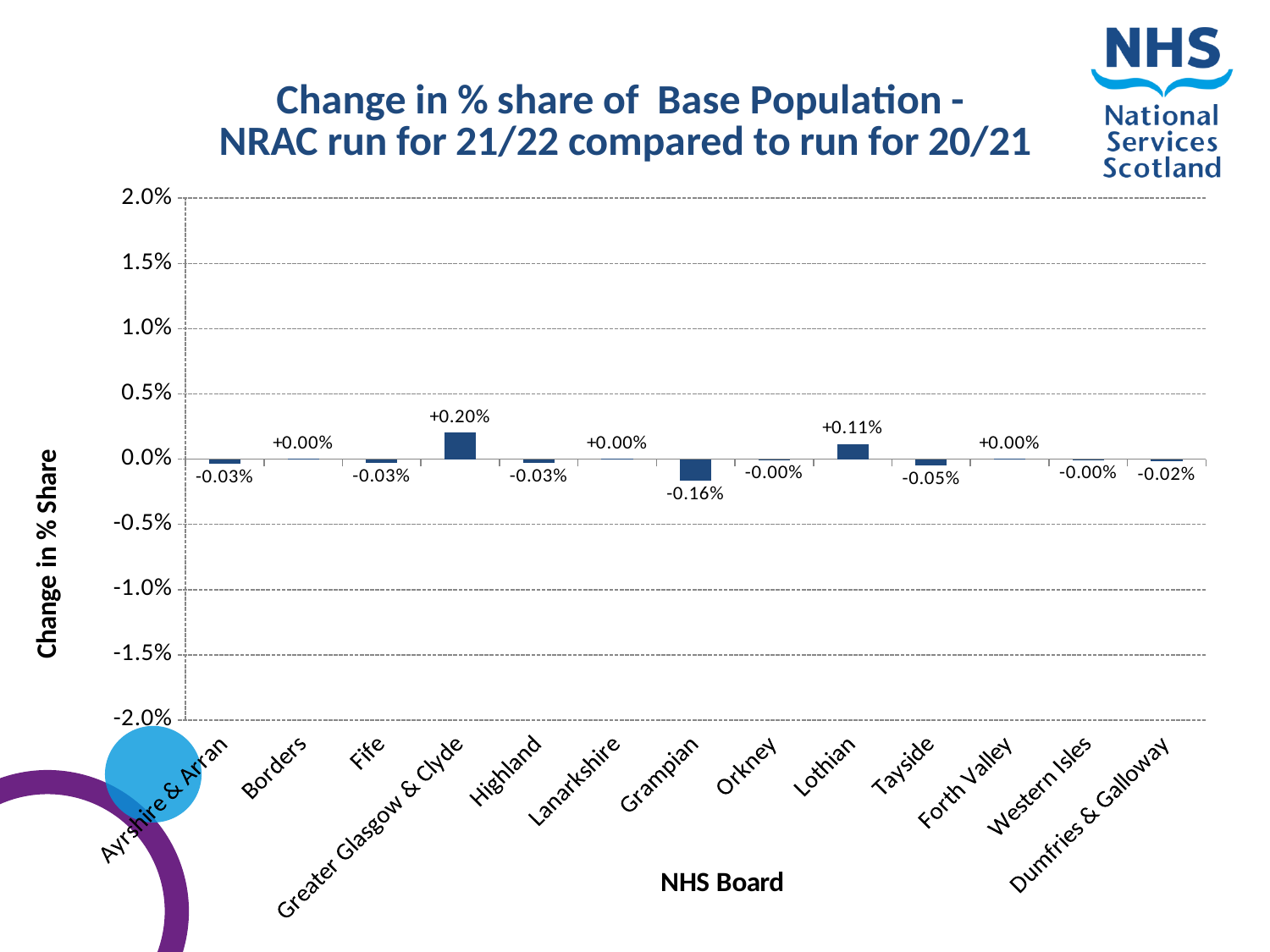
How many NHS Boards are shown on the x axis? 13 What is the change in % share for Tayside? -0.05% What is the change in % share for Lothian? +0.11% What is the change in % share for Greater Glasgow & Clyde? +0.20% Is the value for Greater Glasgow & Clyde greater or less than 0.5%? less What is the change in % share for Grampian? -0.16% Which has the larger change in % share, Lothian or Tayside? Lothian What kind of chart is shown on the slide? Bar chart What is the title of the x axis? NHS Board Which NHS Board has the largest positive change in % share? Greater Glasgow & Clyde By how many percentage points does the change for Greater Glasgow & Clyde exceed the change for Lothian? 0.09 percentage points Which NHS Board has the lowest (most negative) change in % share? Grampian